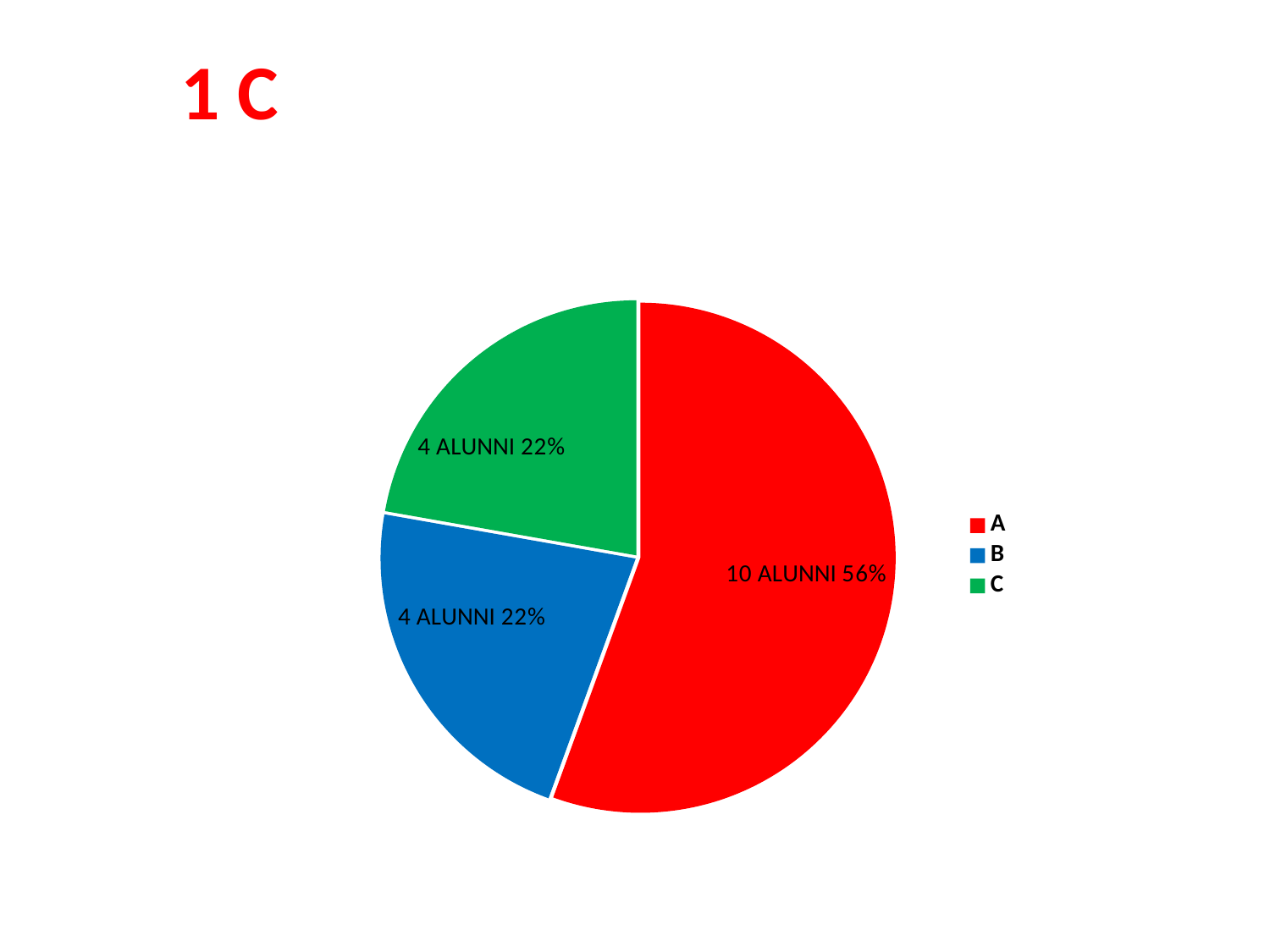
Which is larger, the slice for A or the slice for B? A What share of the pie does slice B represent? 22% What share of the pie does slice A represent? 56% What kind of chart is shown on the slide? pie chart What is the difference in alunni between category A and category C? 6 Which category has the largest slice of the pie? A What colour is the slice for category C? green What share of the pie does slice C represent? 22% How many entries does the legend list? 3 How many alunni are in category B? 4 ALUNNI How many slices does the pie chart have? 3 How many alunni are in category A? 10 ALUNNI